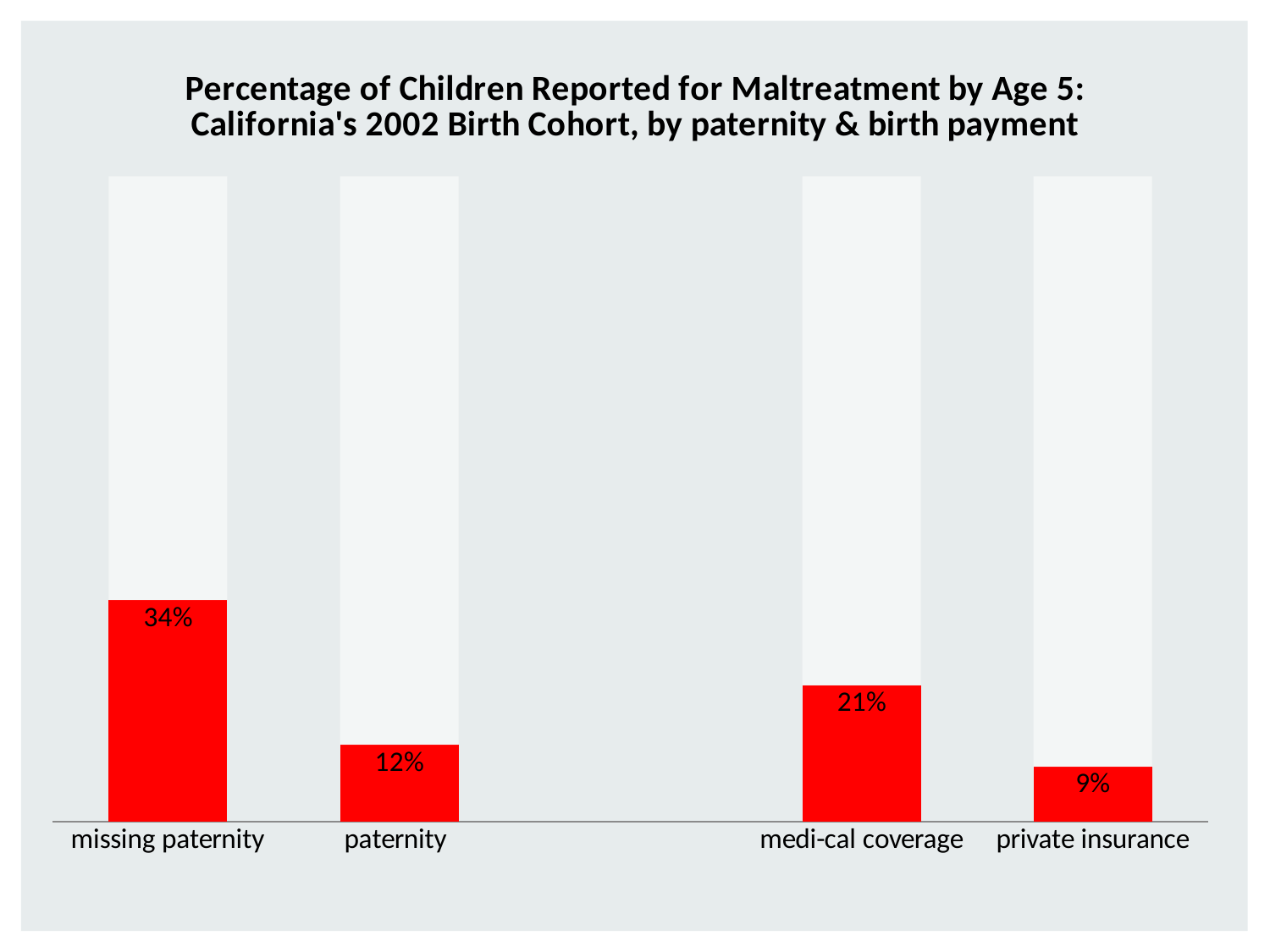
What kind of chart is shown on the slide? bar chart What is the value for paternity? 12% How many categories are shown on the chart? 4 What is the difference between the values for missing paternity and paternity? 22% Which is larger, the value for medi-cal coverage or the value for paternity? medi-cal coverage What is the value for private insurance? 9% What is the difference between the values for medi-cal coverage and private insurance? 12% What is the title of the chart? Percentage of Children Reported for Maltreatment by Age 5: California's 2002 Birth Cohort, by paternity & birth payment Which category has the lowest value? private insurance What is the value for medi-cal coverage? 21% Which category has the highest value? missing paternity What is the value for missing paternity? 34%